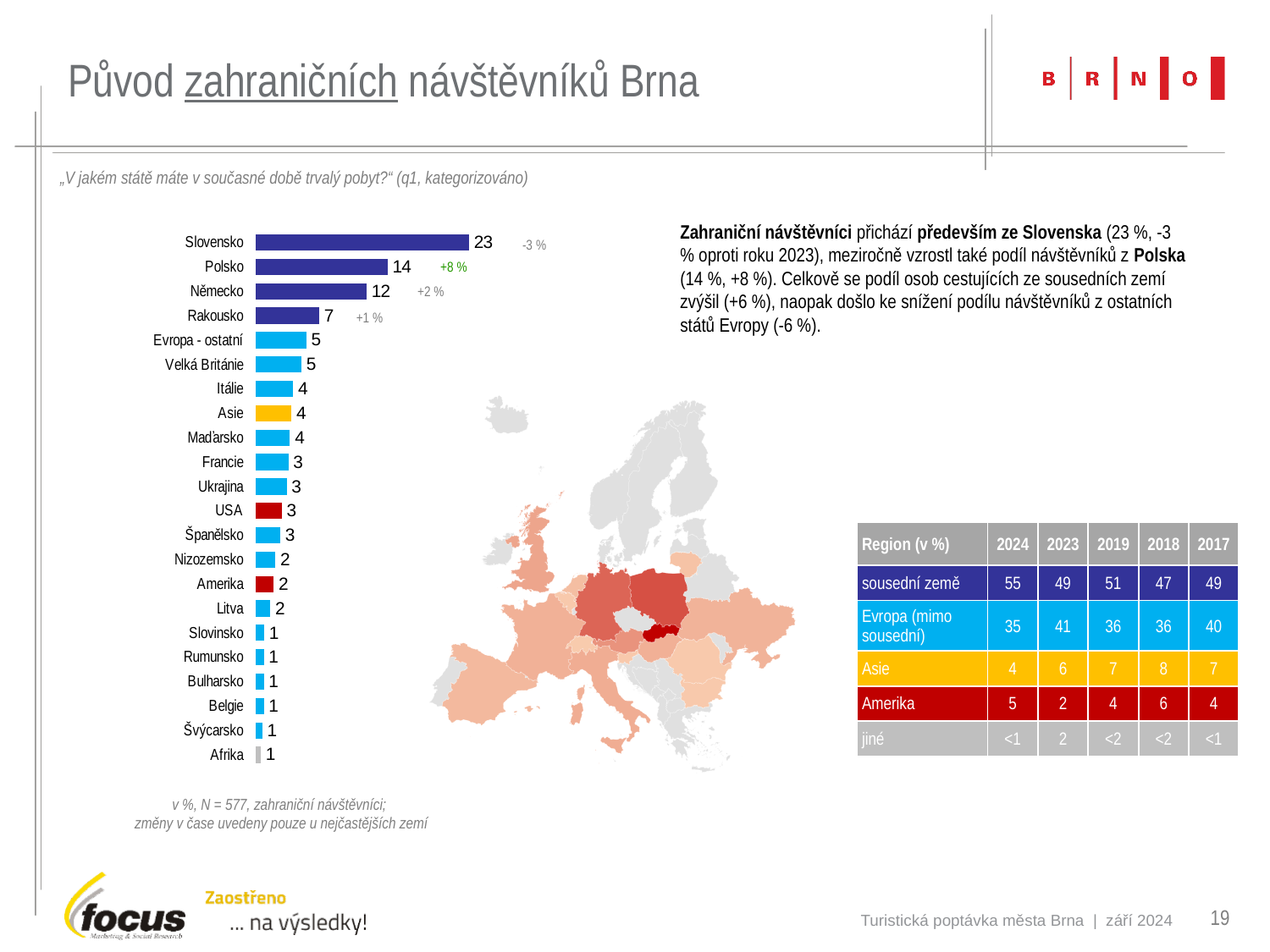
What is the value for Polsko in the bar chart? 14 What year-on-year change is shown next to the Slovensko bar? -3 % What is the value for Německo in the bar chart? 12 What is the value for Rakousko in the bar chart? 7 What is the value for Slovensko in the bar chart? 23 Which country has the highest value in the bar chart? Slovensko How many categories are shown in the bar chart? 22 What is the difference between the values for Slovensko and Polsko in the bar chart? 9 Which has a larger value in the bar chart, Německo or Rakousko? Německo Do the values in the bar chart rise or fall going from the top category to the bottom category? fall What type of chart is used to show the origin of foreign visitors to Brno? bar chart What year-on-year change is shown next to the Polsko bar? +8 %